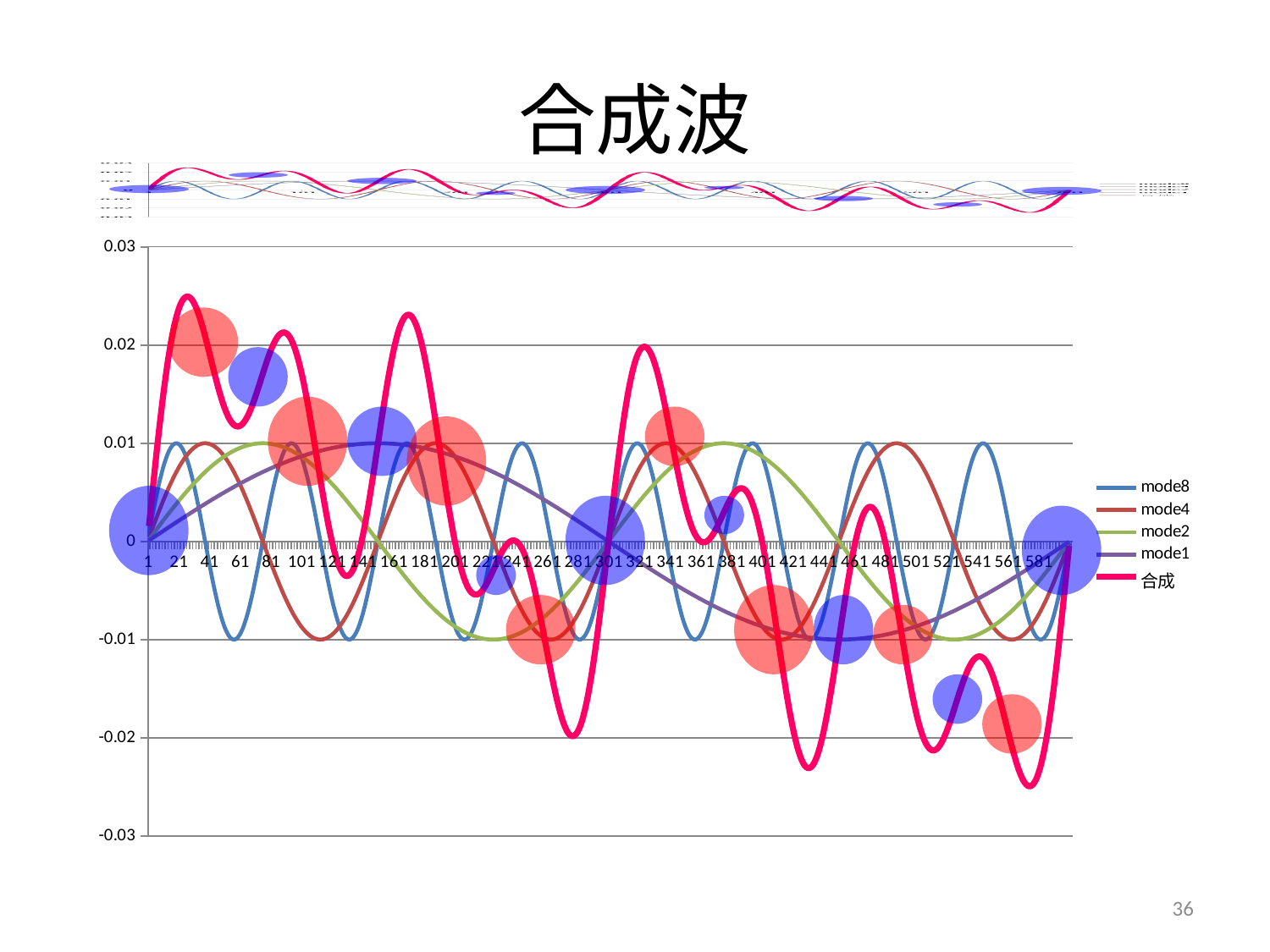
Which series reaches the lowest value on the chart? 合成 Which series reaches the largest peak value on the chart? 合成 Which series is drawn with the thick pink line? 合成 What is the highest value shown on the vertical axis? 0.03 What kind of chart is shown on the slide? line chart What is the title of the slide containing the chart? 合成波 What is the maximum value reached by the mode8 series? 0.01 Is the highest peak of the 合成 series greater or less than 0.02? greater How many series does the legend list? 5 Is the lowest trough of the 合成 series greater or less than -0.02? less Which series has the highest peak, mode8 or 合成? 合成 What is the minimum value reached by the mode1 series? -0.01